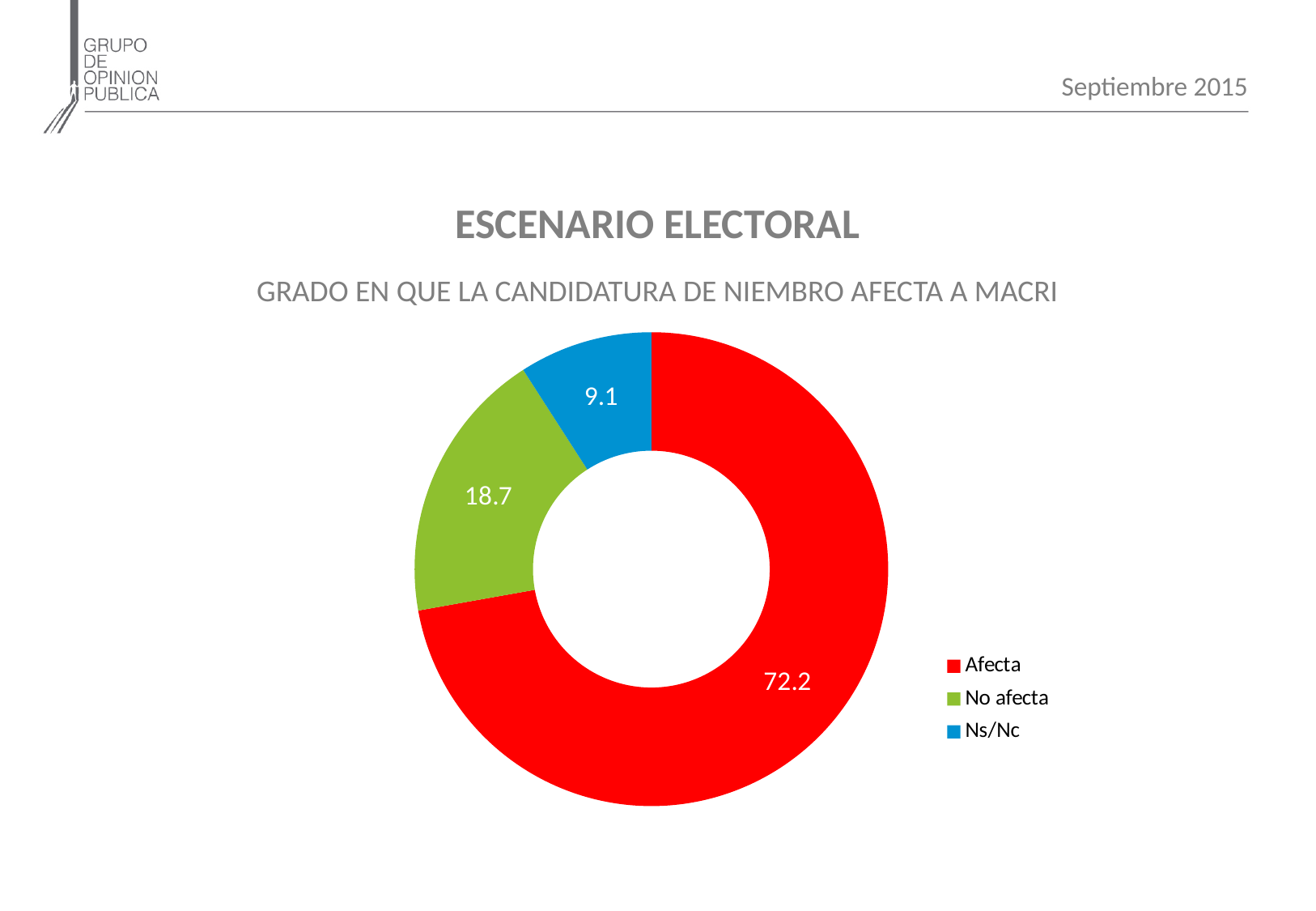
What is the value for No afecta? 18.7 What is the difference between the values for Afecta and No afecta? 53.5 What is the title of the chart? GRADO EN QUE LA CANDIDATURA DE NIEMBRO AFECTA A MACRI Which is larger, the value for No afecta or the value for Ns/Nc? No afecta What is the value for Ns/Nc? 9.1 What colour represents Ns/Nc in the chart? Blue Which category has the largest share of the chart? Afecta How many categories does the chart show? 3 What is the difference between the values for No afecta and Ns/Nc? 9.6 What is the value for Afecta? 72.2 Which category has the smallest share of the chart? Ns/Nc What kind of chart is shown on the slide? Pie chart (doughnut)